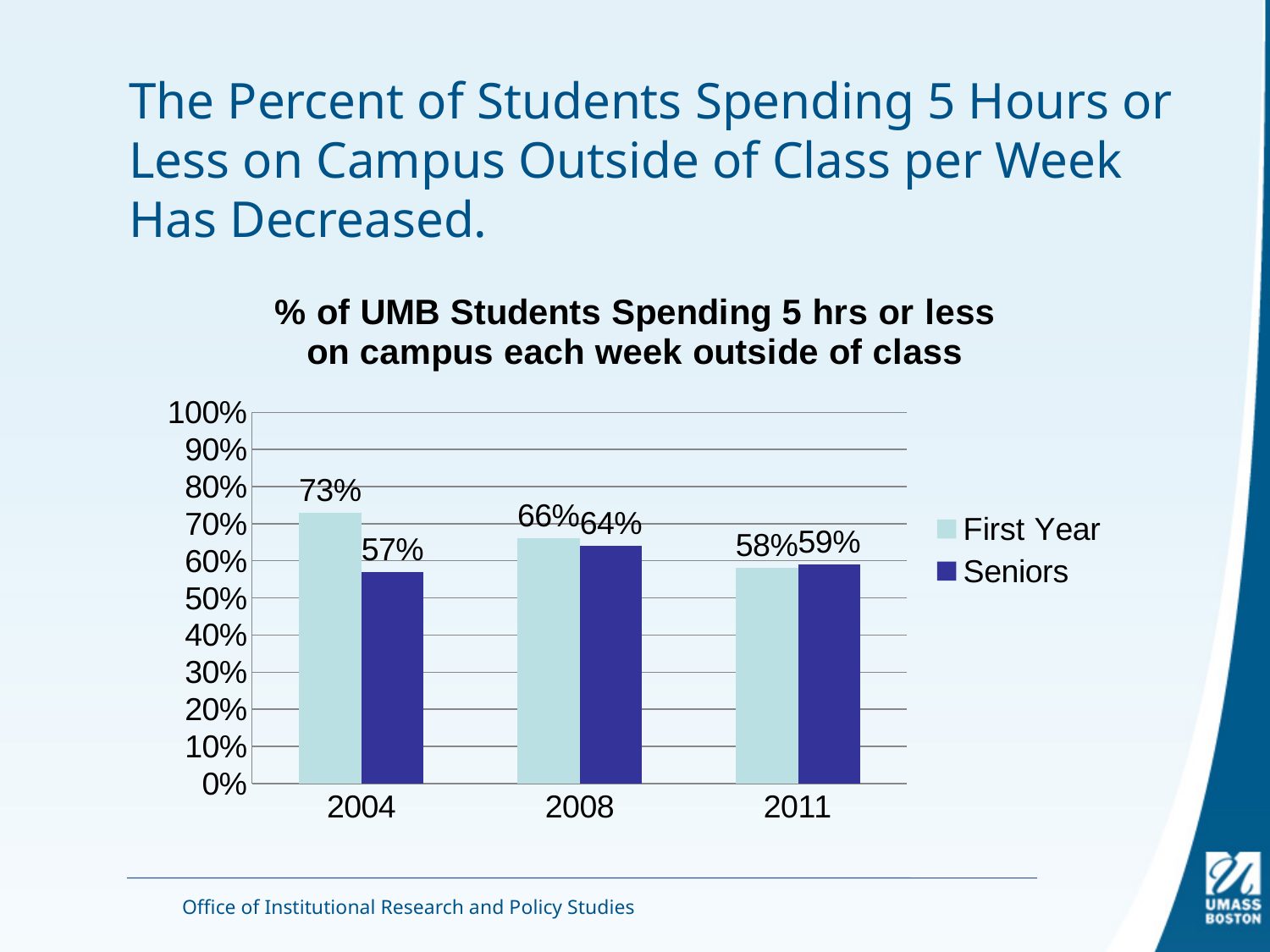
What is the difference between the First Year and Seniors values in 2004? 16% What is the value for Seniors in 2008? 64% In which year is the First Year value highest? 2004 How many series does the legend list? 2 What is the title of the chart? % of UMB Students Spending 5 hrs or less on campus each week outside of class What is the value for Seniors in 2011? 59% In which year is the Seniors value lowest? 2004 What is the value for First Year students in 2004? 73% How many years are shown on the x axis? 3 What kind of chart is shown? Bar chart Which is larger in 2008, the First Year value or the Seniors value? First Year Do the First Year values rise or fall from 2004 to 2011? Fall